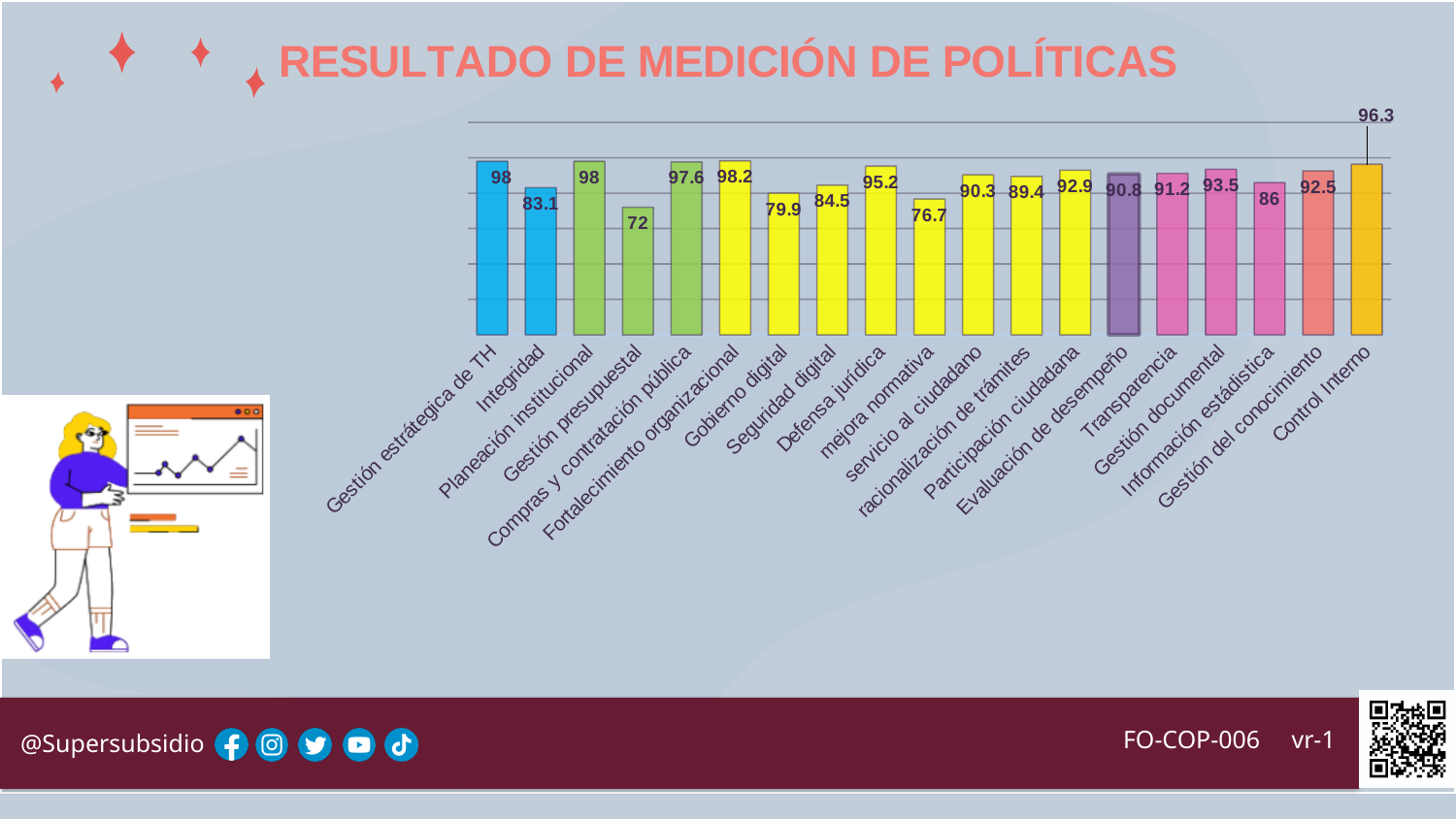
What kind of chart is shown on the slide? Bar chart What is the value for Integridad? 83.1 What is the value for Gestión documental? 93.5 What is the difference between the values for Gestión estratégica de TH and Gestión presupuestal? 26 Which category has the highest value? Fortalecimiento organizacional Which is larger, the value for Gobierno digital or the value for Seguridad digital? Seguridad digital What is the value for Control Interno? 96.3 What is the value for Gestión presupuestal? 72 Which category has the lowest value? Gestión presupuestal How many categories are shown in the chart? 19 What is the difference between the values for Control Interno and Información estadística? 10.3 What is the title of the slide? RESULTADO DE MEDICIÓN DE POLÍTICAS